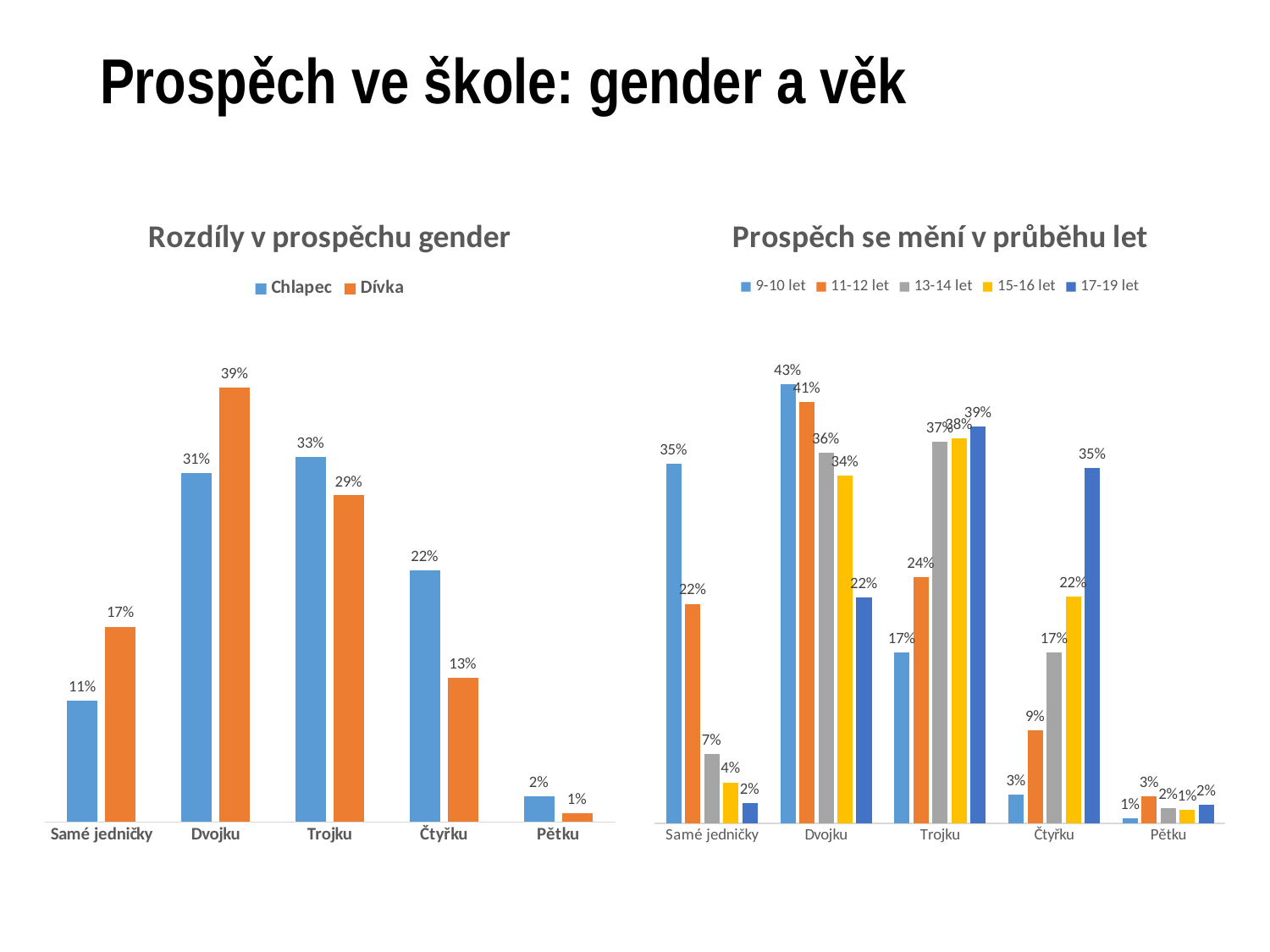
In the chart 'Prospěch se mění v průběhu let', which age group has the lowest value in the Samé jedničky category? 17-19 let In the chart 'Prospěch se mění v průběhu let', do the values in the Čtyřku category rise or fall as the age groups get older? rise In the chart 'Rozdíly v prospěchu gender', which is larger in the Trojku category, Chlapec or Dívka? Chlapec In the chart 'Prospěch se mění v průběhu let', what is the value for 17-19 let in the Čtyřku category? 35% In the chart 'Rozdíly v prospěchu gender', what is the difference between Dívka and Chlapec in the Samé jedničky category? 6% In the chart 'Prospěch se mění v průběhu let', what is the difference between 9-10 let and 17-19 let in the Dvojku category? 21% In the chart 'Rozdíly v prospěchu gender', which category has the highest value for Chlapec? Trojku In the chart 'Prospěch se mění v průběhu let', what is the value for 9-10 let in the Dvojku category? 43% In the chart 'Rozdíly v prospěchu gender', what is the value for Chlapec in the Čtyřku category? 22% How many series does the legend of the chart 'Prospěch se mění v průběhu let' list? 5 What type of chart is 'Rozdíly v prospěchu gender'? bar chart In the chart 'Rozdíly v prospěchu gender', what is the value for Dívka in the Dvojku category? 39%